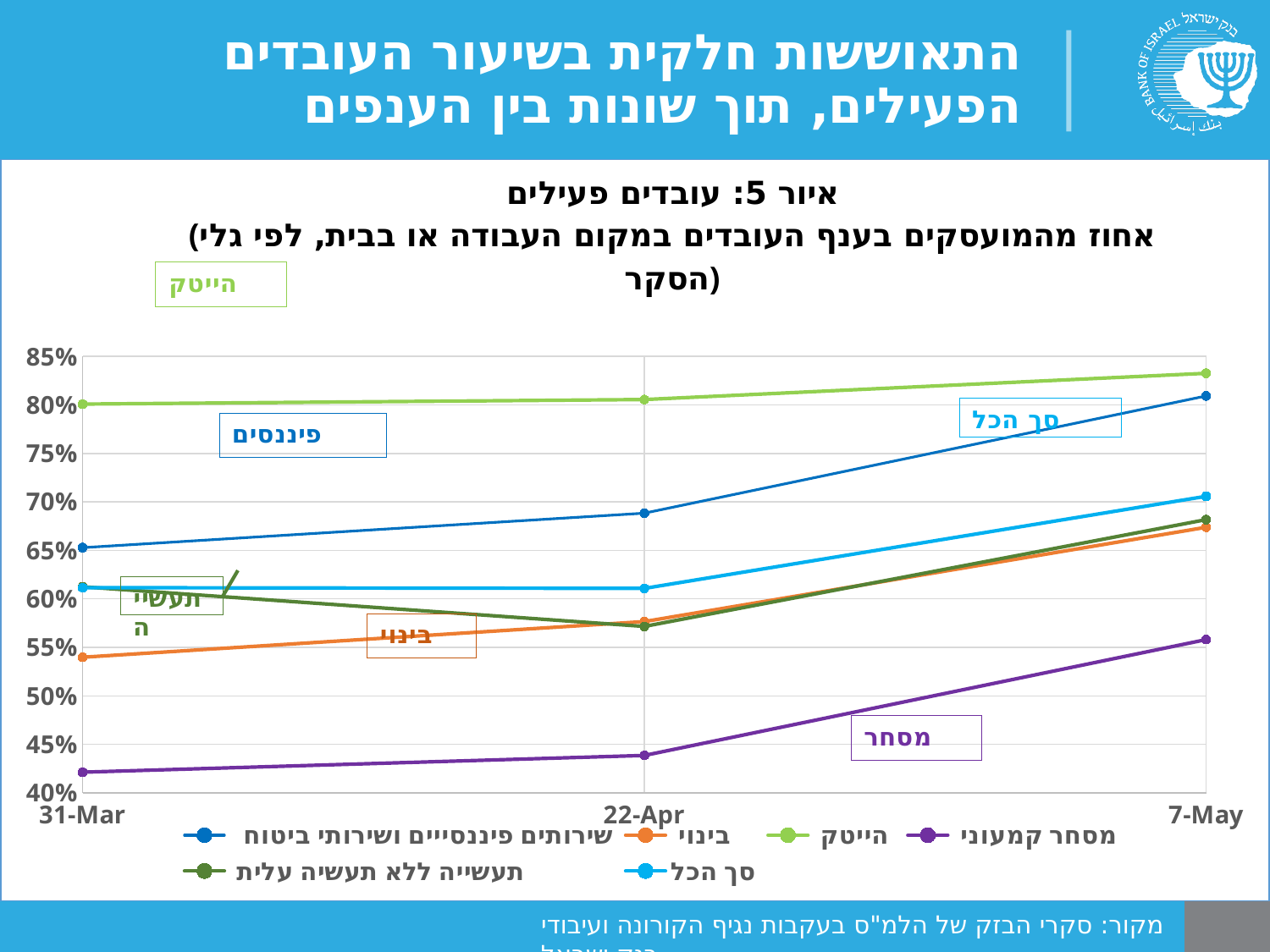
Which series has the lowest value on 7-May? מסחר קמעוני Is the value for שירותים פיננסיים ושירותי ביטוח on 22-Apr greater or less than 65%? greater Which series has the lowest value on 31-Mar? מסחר קמעוני Is the value for מסחר קמעוני on 31-Mar greater or less than 45%? less How many dates are shown on the x axis of the chart? 3 What kind of chart is shown on the slide? line chart How many series does the chart legend list? 6 On 7-May, which is larger: שירותים פיננסיים ושירותי ביטוח or סך הכל? שירותים פיננסיים ושירותי ביטוח Is the value for הייטק on 7-May greater or less than 80%? greater What is the first date shown on the x axis of the chart? 31-Mar Does the value for מסחר קמעוני rise or fall from 31-Mar to 7-May? rise Which series has the highest value on 7-May? הייטק